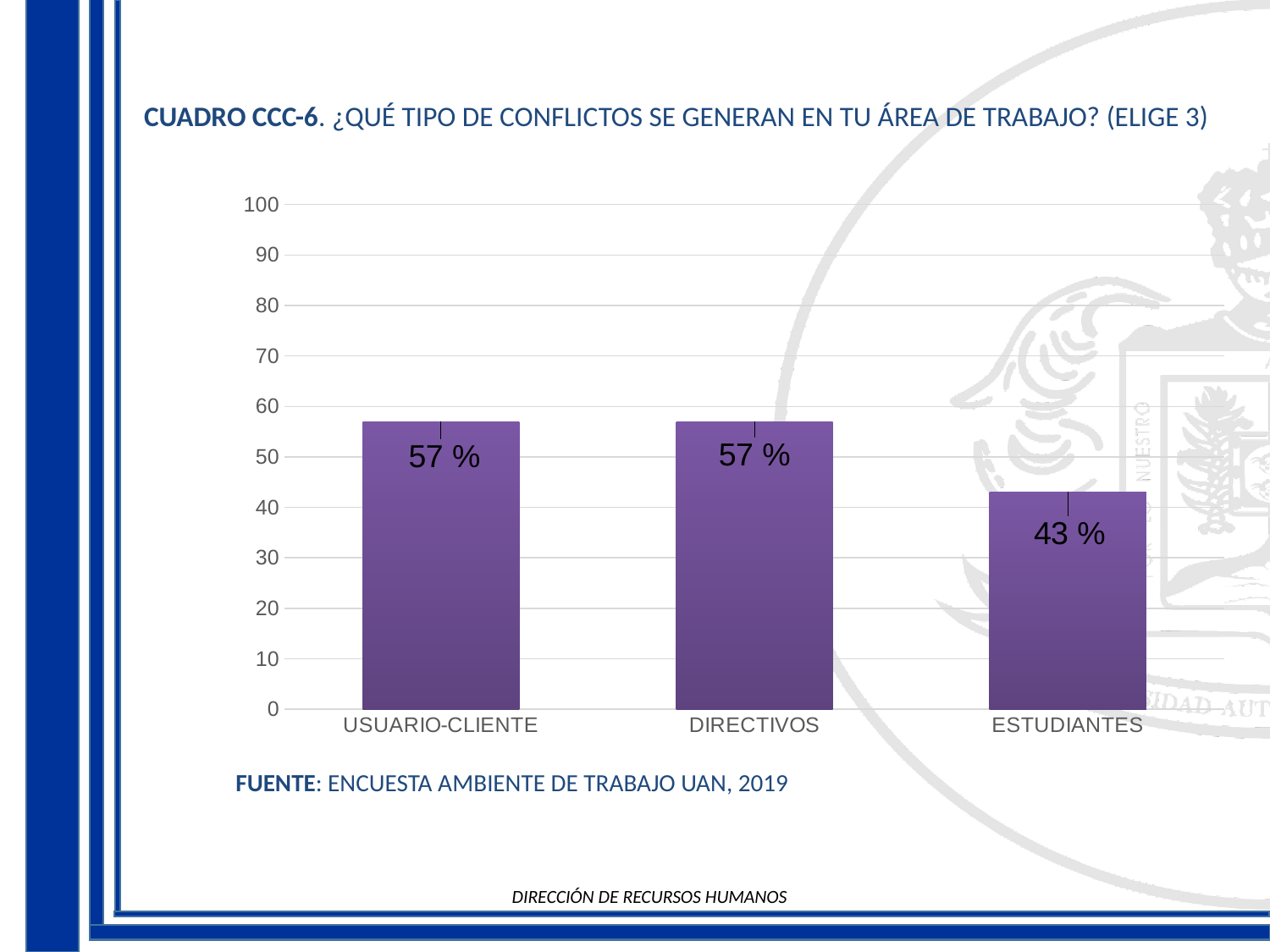
What is the value for USUARIO-CLIENTE? 57 % What source is cited below the chart? ENCUESTA AMBIENTE DE TRABAJO UAN, 2019 How many categories are shown on the chart? 3 What is the maximum value shown on the vertical axis? 100 Which is larger, the value for USUARIO-CLIENTE or the value for ESTUDIANTES? USUARIO-CLIENTE Which category has the lowest value? ESTUDIANTES What is the difference between the values for DIRECTIVOS and ESTUDIANTES? 14 % What is the value for ESTUDIANTES? 43 % Is the value for ESTUDIANTES greater or less than 50? less What is the value for DIRECTIVOS? 57 % What kind of chart is shown on the slide? bar chart Is the value for DIRECTIVOS greater or less than 50? greater